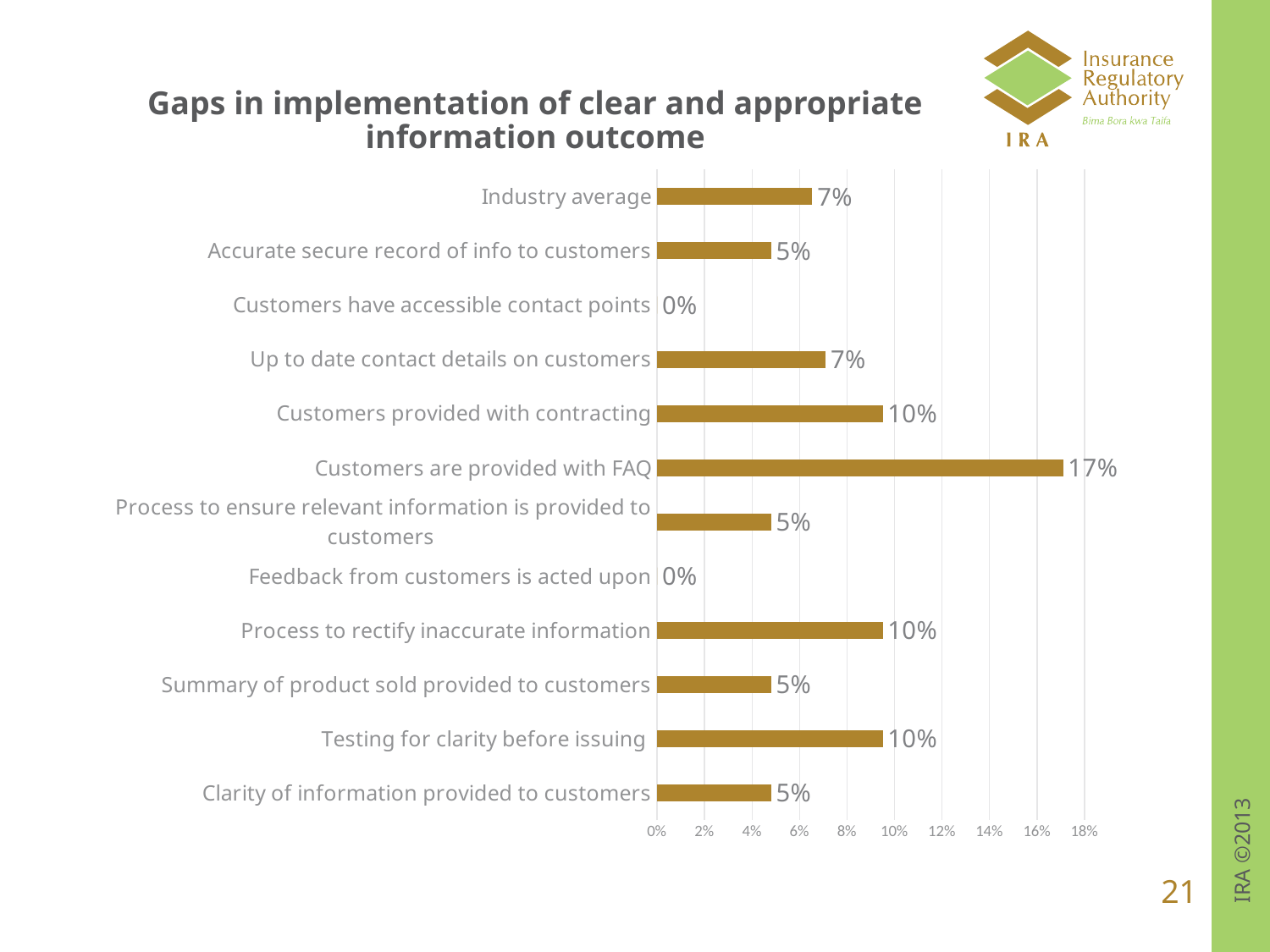
What is the value for Industry average? 7% What is the value for Customers are provided with FAQ? 17% What kind of chart is shown on the slide? bar chart Which category has the highest value? Customers are provided with FAQ What is the difference between Customers are provided with FAQ and Customers provided with contracting? 7% What is the title of the slide? Gaps in implementation of clear and appropriate information outcome What is the value for Testing for clarity before issuing? 10% How many categories have a value of 0%? 2 What is the value for Feedback from customers is acted upon? 0% Is the value for Customers are provided with FAQ greater or less than 16%? greater Which is larger, Up to date contact details on customers or Summary of product sold provided to customers? Up to date contact details on customers How many categories are shown on the chart? 12